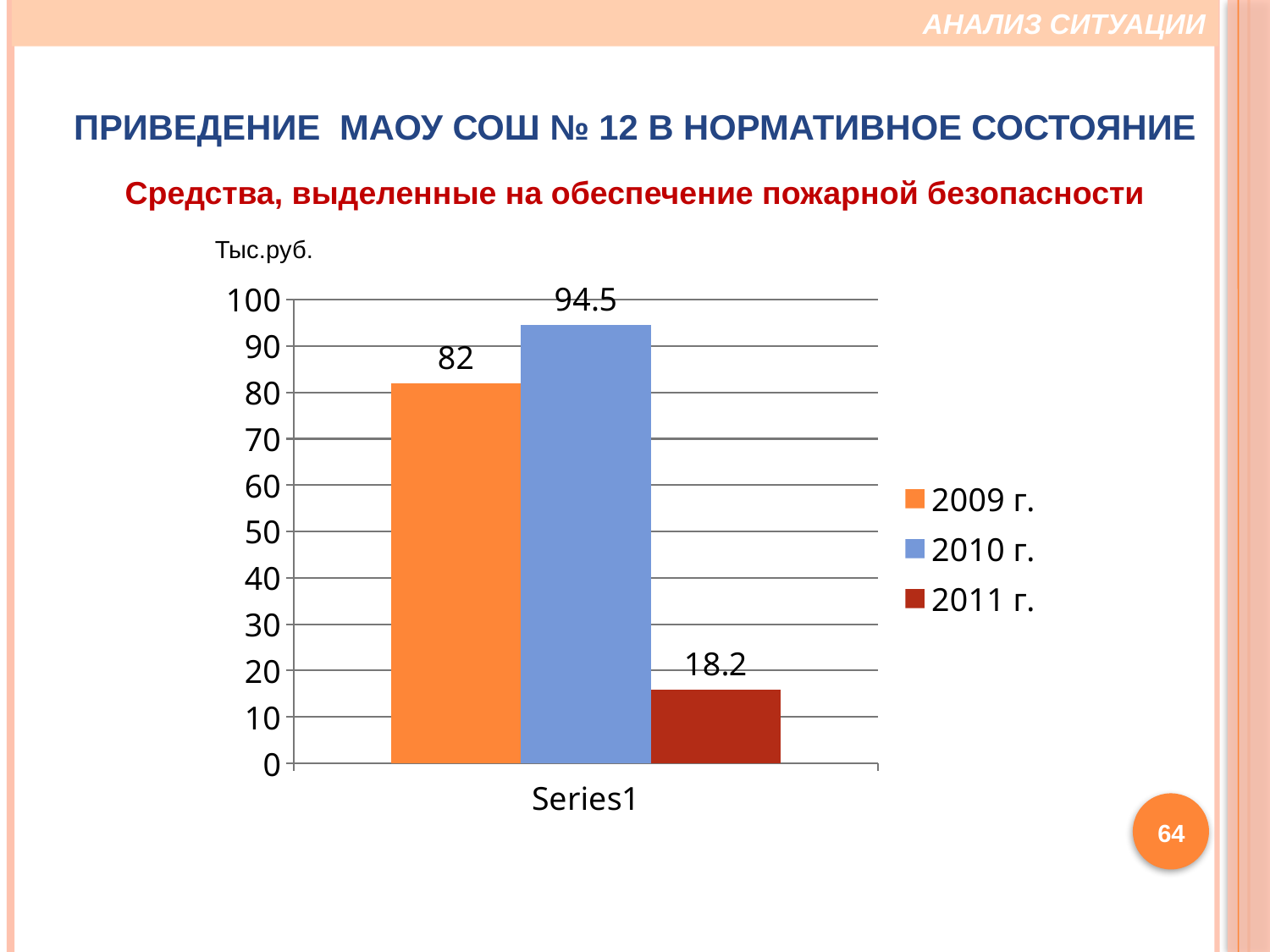
What is the difference between the values for 2010 г. and 2009 г.? 12.5 Which year has the highest value? 2010 г. What unit is indicated above the chart's vertical axis? Тыс.руб. What kind of chart is shown on the slide? bar chart What value is shown for 2011 г.? 18.2 Which is larger, the value for 2009 г. or the value for 2011 г.? 2009 г. Which year has the lowest value? 2011 г. What is the difference between the values for 2009 г. and 2011 г.? 63.8 What value is shown for 2009 г.? 82 How many series does the legend list? 3 What value is shown for 2010 г.? 94.5 Is the value for 2011 г. greater or less than 20? less